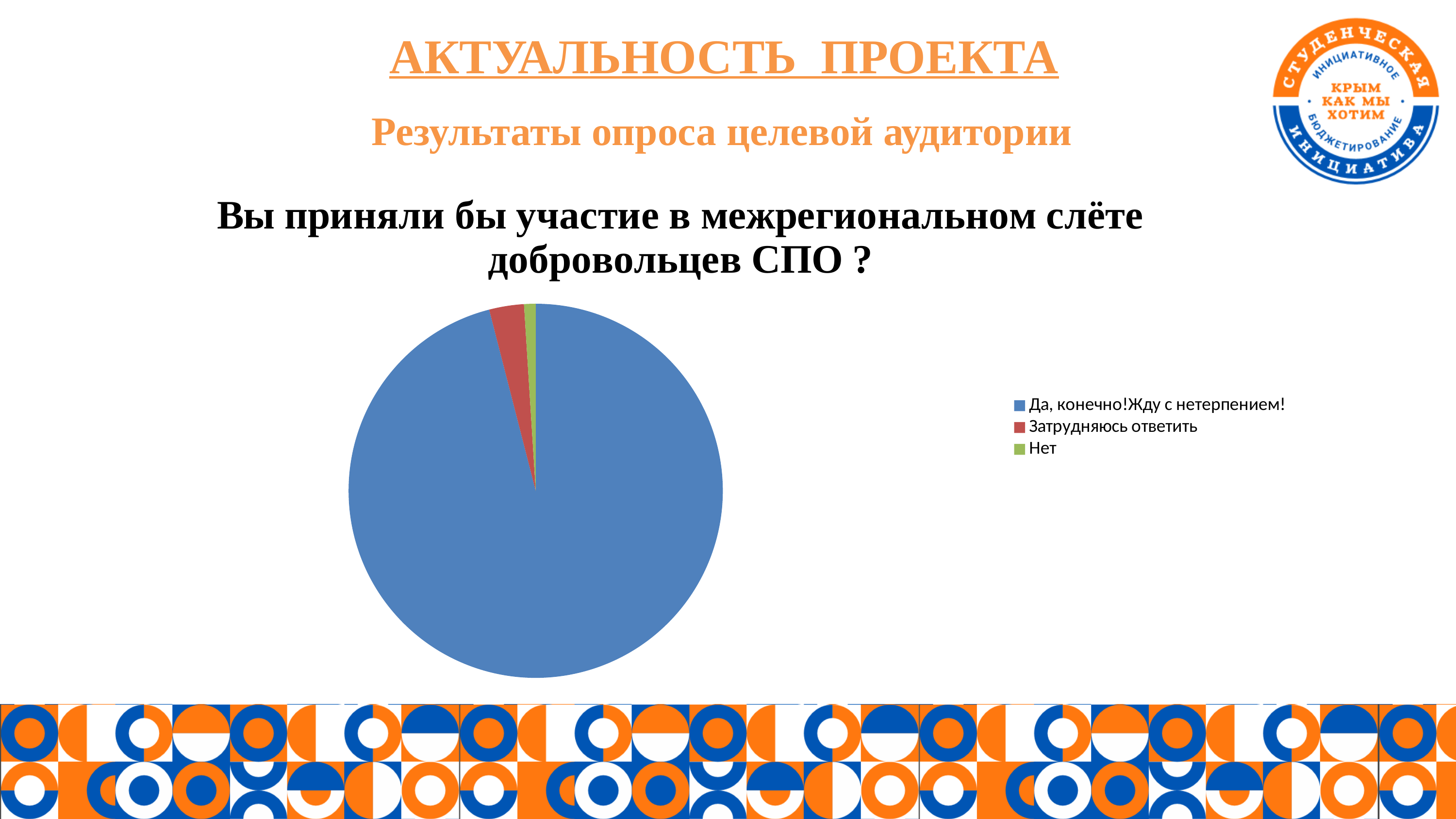
What question is the pie chart reporting the survey results for? Вы приняли бы участие в межрегиональном слёте добровольцев СПО ? Which slice is larger: "Да, конечно!Жду с нетерпением!" or "Затрудняюсь ответить"? Да, конечно!Жду с нетерпением! How many slices does the pie chart have? 3 What colour is the slice for "Нет" in the pie chart? Green How many entries does the legend of the pie chart list? 3 Which answer option has the smallest slice in the pie chart? Нет What kind of chart is shown on the slide? Pie chart Which answer option has the largest slice in the pie chart? Да, конечно!Жду с нетерпением! Which slice is larger: "Затрудняюсь ответить" or "Нет"? Затрудняюсь ответить